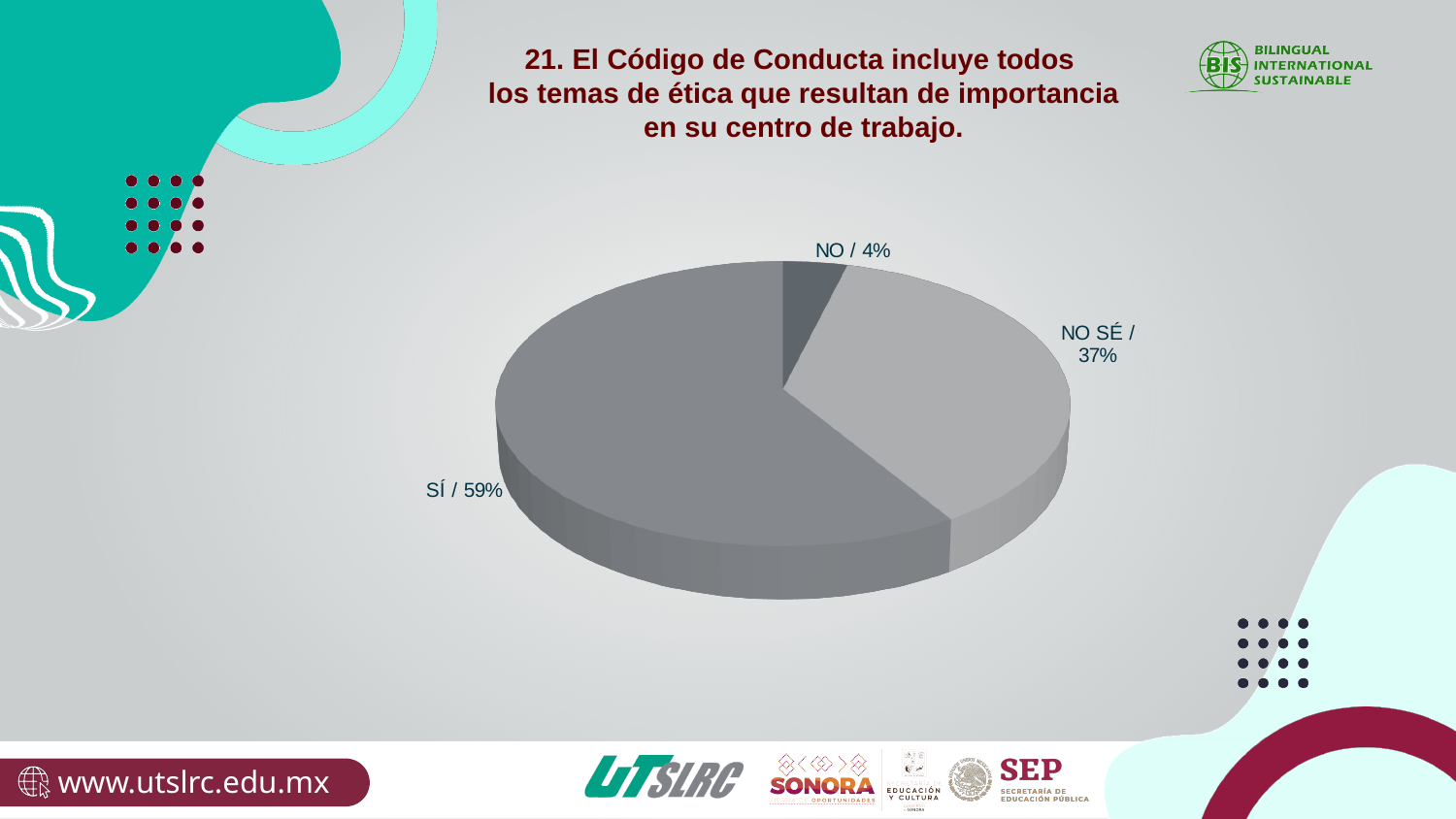
What percentage of responses are "NO"? 4% What is the difference in percentage points between "SÍ" and "NO SÉ"? 22 What is the number of the survey question shown in the chart title? 21 Which response has the smallest share of the pie? NO What is the difference in percentage points between "NO SÉ" and "NO"? 33 How many slices does the pie chart have? 3 What percentage of responses are "NO SÉ"? 37% What kind of chart is shown on the slide? pie chart What is the combined percentage of "NO" and "NO SÉ" responses? 41% Which is larger, the share for "NO SÉ" or the share for "NO"? NO SÉ What percentage of responses are "SÍ"? 59% Which response has the largest share of the pie? SÍ